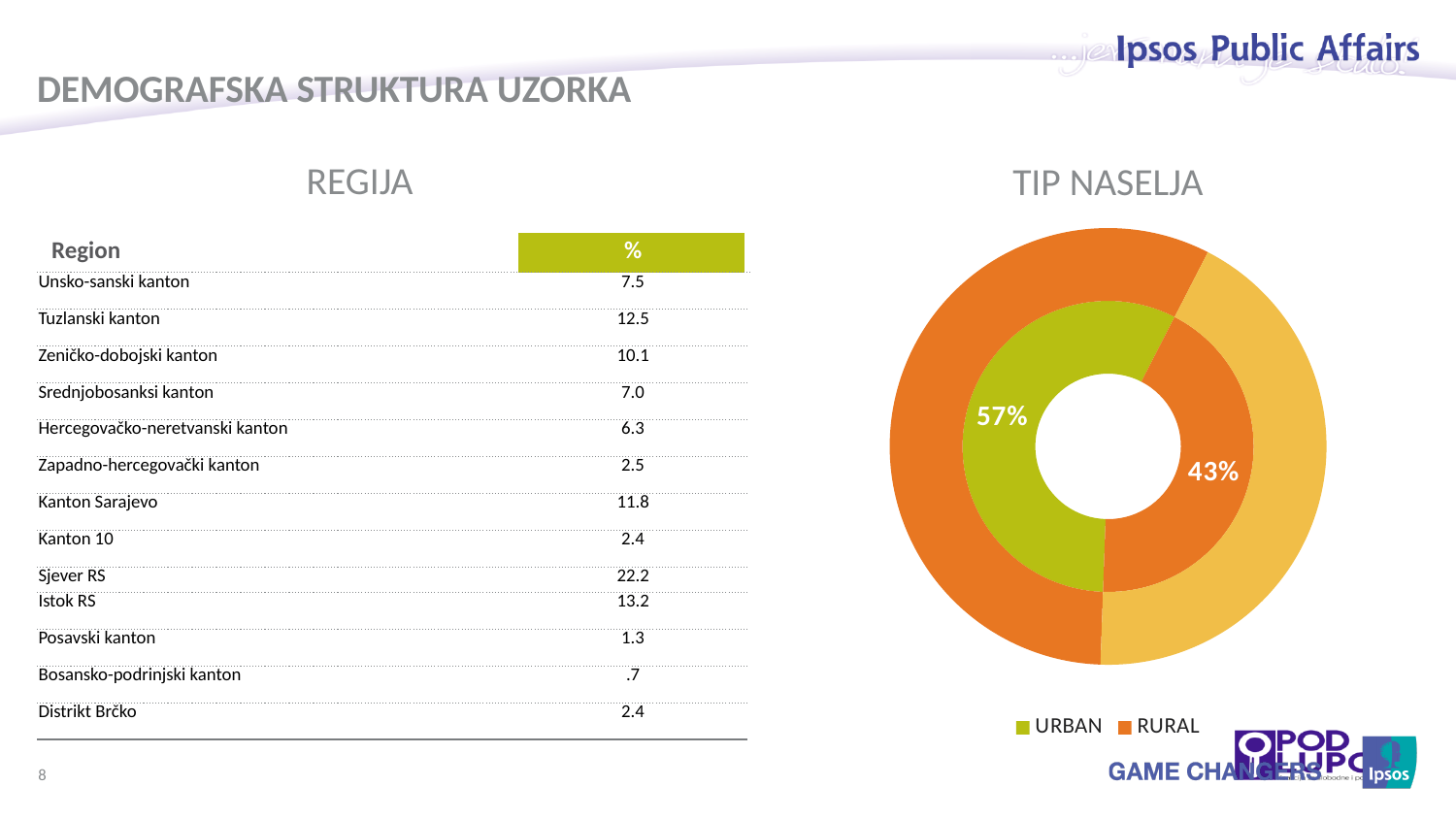
In the TIP NASELJA chart, which category has the larger share? URBAN In the TIP NASELJA chart, is the URBAN share larger or smaller than the RURAL share? Larger In the TIP NASELJA chart, what do the URBAN and RURAL shares add up to? 100% In the TIP NASELJA chart, which category has the smaller share? RURAL In the TIP NASELJA chart, which colour represents URBAN in the legend? Green What kind of chart is shown under the title TIP NASELJA? Doughnut chart In the TIP NASELJA chart, what percentage is shown for URBAN? 57% How many categories are shown in the TIP NASELJA chart? 2 How many entries does the legend of the TIP NASELJA chart list? 2 In the TIP NASELJA chart, what is the difference in percentage points between URBAN and RURAL? 14 In the TIP NASELJA chart, is the URBAN share greater or less than 50%? greater In the TIP NASELJA chart, what percentage is shown for RURAL? 43%